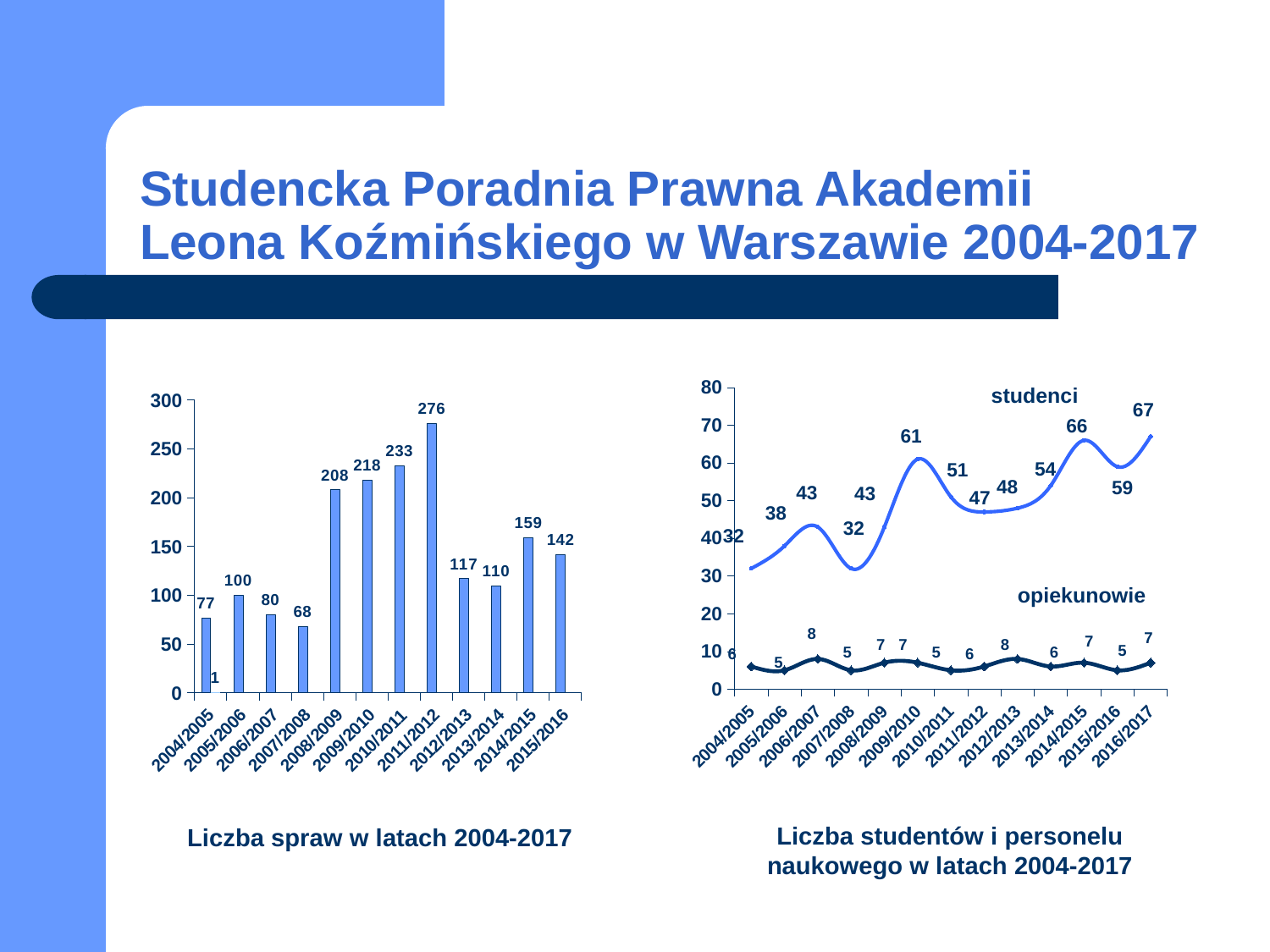
In the left chart 'Liczba spraw w latach 2004-2017', which is larger, the value for 2014/2015 or for 2015/2016? 2014/2015 What kind of chart is the right chart, 'Liczba studentów i personelu naukowego w latach 2004-2017'? line chart How many series are shown in the right chart 'Liczba studentów i personelu naukowego w latach 2004-2017'? 2 In the right chart 'Liczba studentów i personelu naukowego w latach 2004-2017', what is the value for studenci in 2009/2010? 61 In the right chart 'Liczba studentów i personelu naukowego w latach 2004-2017', in which year is the studenci value highest? 2016/2017 How many years are shown on the x axis of the right chart 'Liczba studentów i personelu naukowego w latach 2004-2017'? 13 In the right chart 'Liczba studentów i personelu naukowego w latach 2004-2017', what is the value for opiekunowie in 2006/2007? 8 In the left chart 'Liczba spraw w latach 2004-2017', what is the value for 2011/2012? 276 In the left chart 'Liczba spraw w latach 2004-2017', which year has the highest value? 2011/2012 In the left chart 'Liczba spraw w latach 2004-2017', what is the value for 2008/2009? 208 What kind of chart is the left chart, 'Liczba spraw w latach 2004-2017'? bar chart In the left chart 'Liczba spraw w latach 2004-2017', what is the difference between the values for 2011/2012 and 2010/2011? 43